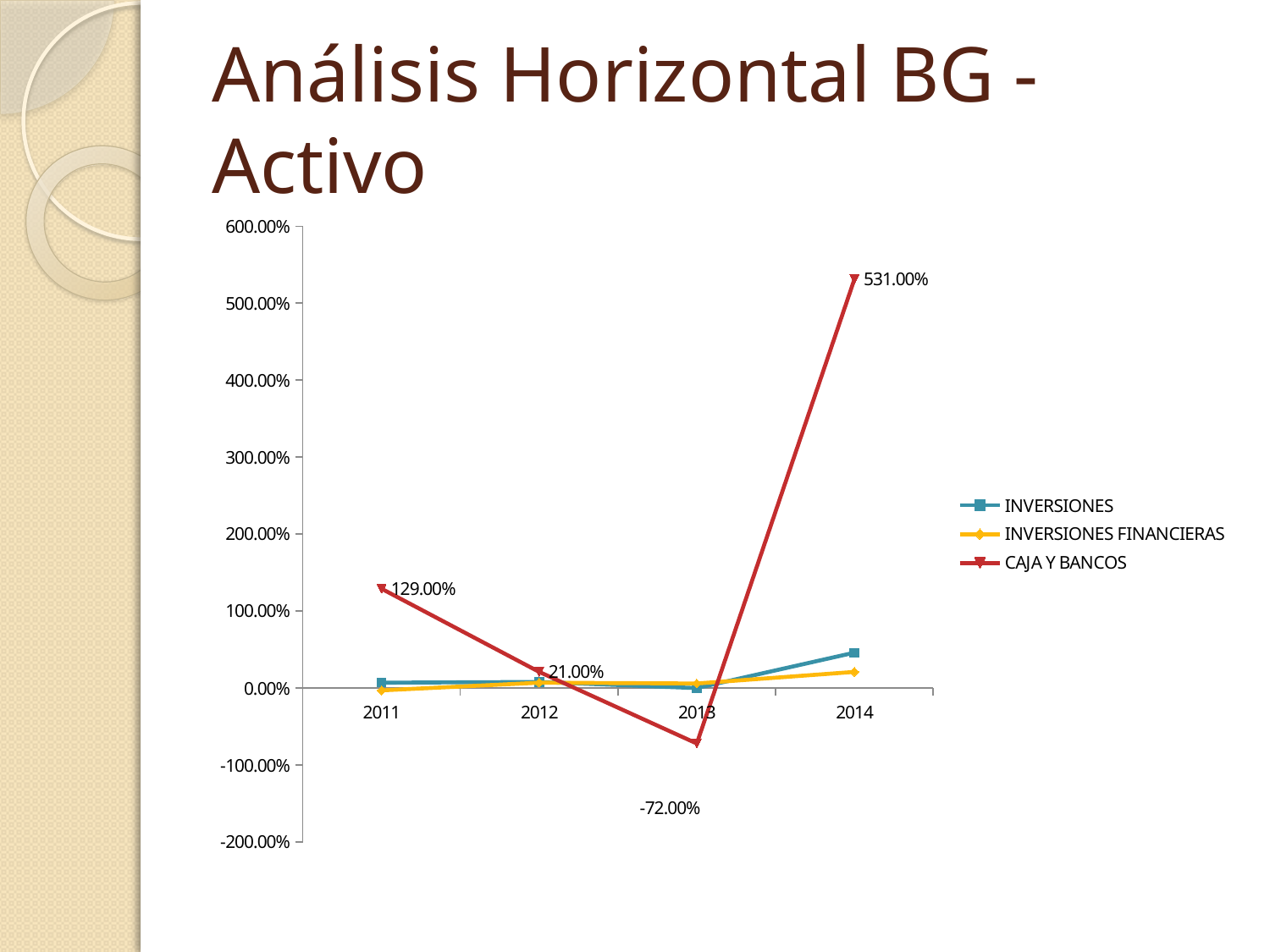
What kind of chart is shown on the slide? line chart In which year does CAJA Y BANCOS reach its highest value? 2014 Is the value for INVERSIONES in 2014 greater or less than 100.00%? less In which year does CAJA Y BANCOS reach its lowest value? 2013 How many years are shown on the x axis? 4 What is the value for CAJA Y BANCOS in 2011? 129.00% What is the value for CAJA Y BANCOS in 2012? 21.00% What is the difference between the CAJA Y BANCOS values for 2014 and 2011? 402.00% How many series does the legend list? 3 What is the value for CAJA Y BANCOS in 2013? -72.00% What is the value for CAJA Y BANCOS in 2014? 531.00% Which is larger for CAJA Y BANCOS, the value in 2011 or the value in 2012? 2011